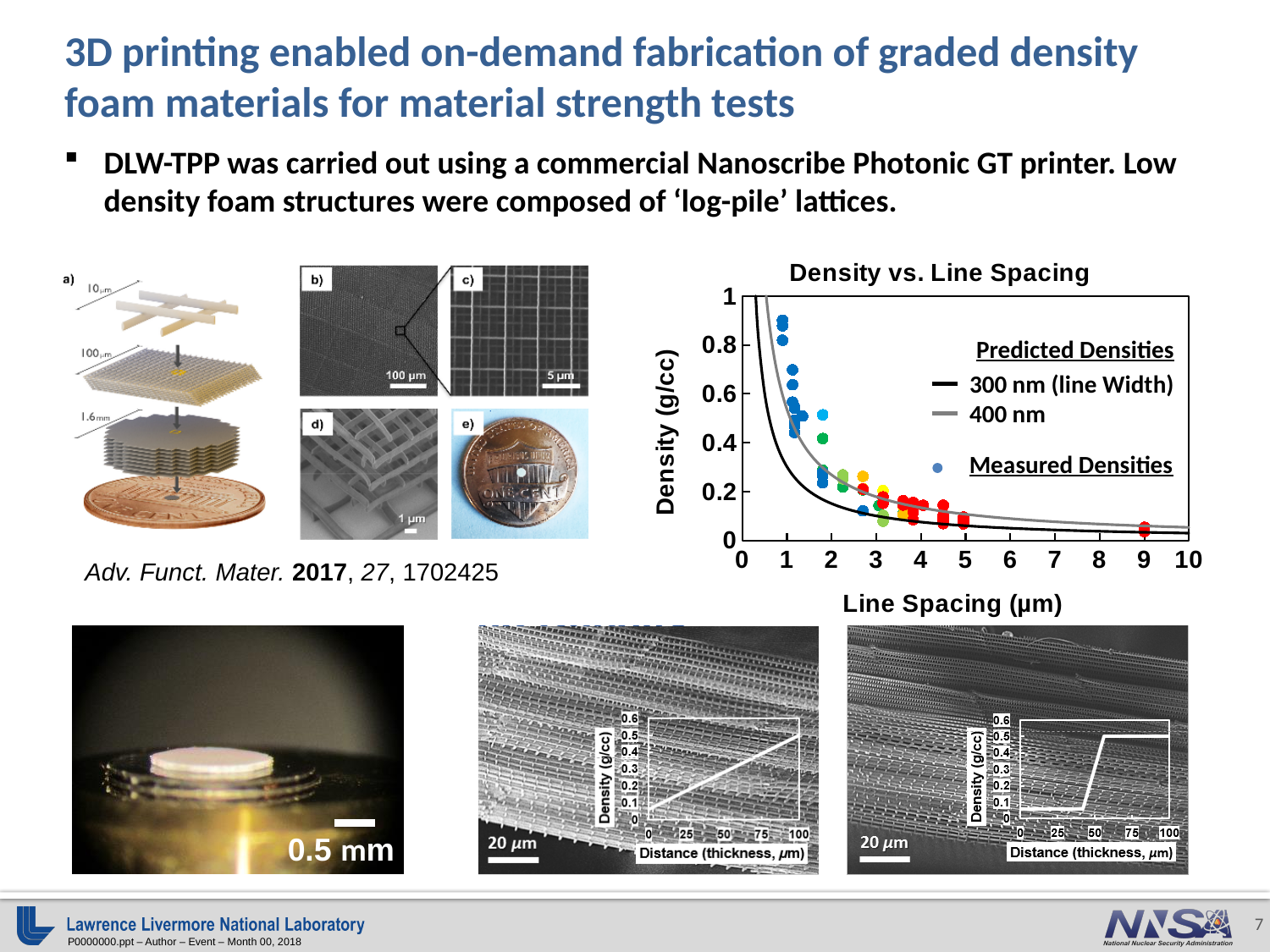
In the 'Density vs. Line Spacing' chart, what is the maximum value shown on the x axis? 10 In the 'Density vs. Line Spacing' chart, what kind of chart is used to show the measured densities? Scatter plot In the 'Density vs. Line Spacing' chart, what is the label of the y axis? Density (g/cc) In the 'Density vs. Line Spacing' chart, is the highest measured density at a line spacing of about 1 µm greater or less than 0.8 g/cc? greater In the 'Density vs. Line Spacing' chart, which line width does the grey predicted-density curve correspond to? 400 nm In the inset chart of the bottom-middle SEM image, does density rise or fall as distance (thickness) increases from 0 to 100 µm? Rise In the 'Density vs. Line Spacing' chart, how many entries does the legend list? 3 In the 'Density vs. Line Spacing' chart, does density rise or fall as line spacing increases? Fall In the 'Density vs. Line Spacing' chart, what is the label of the x axis? Line Spacing (µm) In the 'Density vs. Line Spacing' chart, which line width does the black predicted-density curve correspond to? 300 nm In the 'Density vs. Line Spacing' chart, are the measured densities at a line spacing of 9 µm greater or less than 0.2 g/cc? less